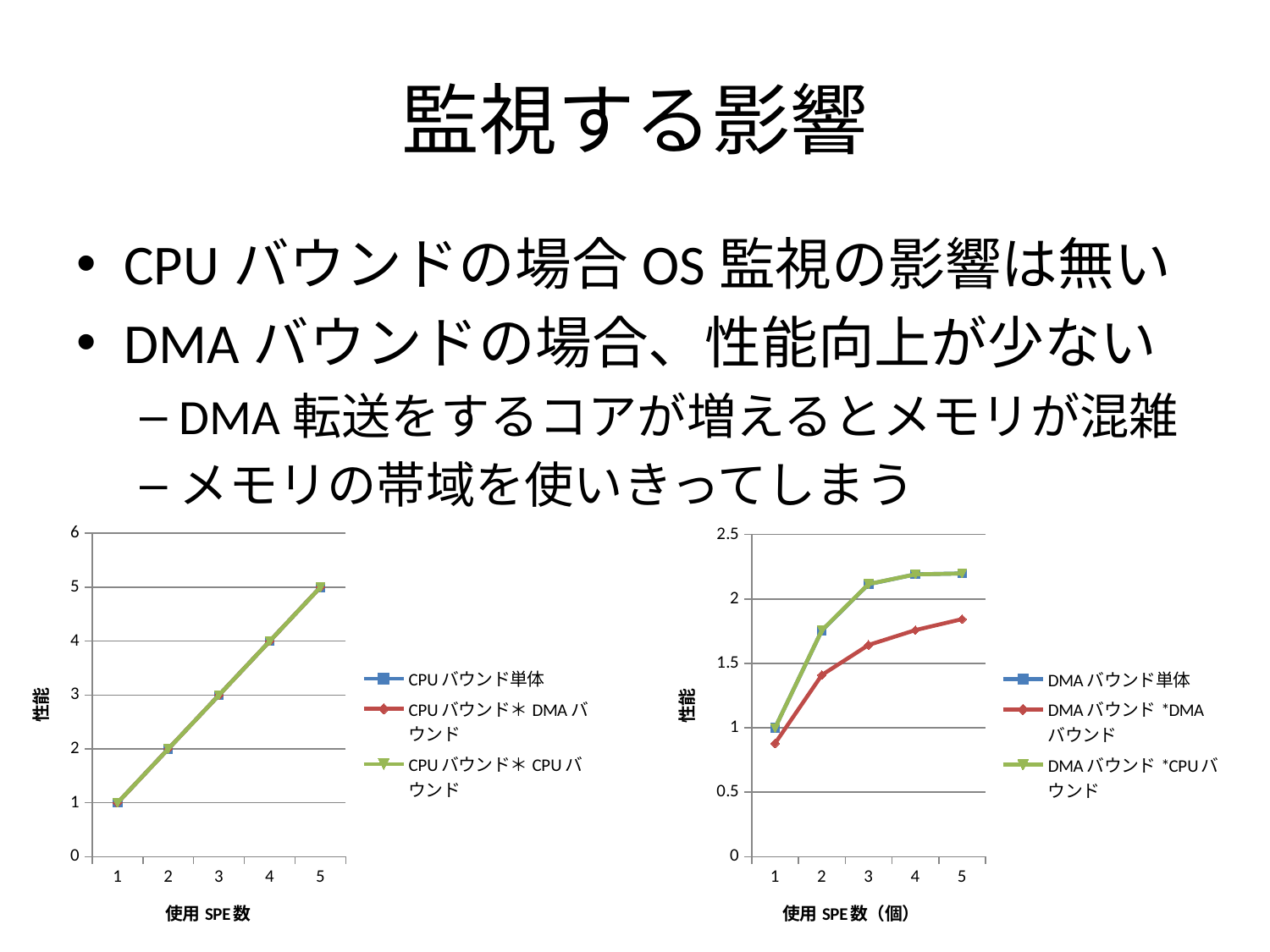
In the left chart, what is the performance value for CPU バウンド＊CPU バウンド at 3 SPEs? 3 How many series does the legend of the right chart list? 3 In the right chart, is the value for DMA バウンド *DMA バウンド at 5 SPEs greater or less than 2? less What kind of chart is the left chart (CPU bound)? line chart What is the x-axis title of the right chart? 使用 SPE 数（個） In the left chart, what is the performance value for CPU バウンド単体 at 5 SPEs? 5 In the left chart, how many SPE counts are plotted along the x axis? 5 In the right chart, at 5 SPEs, which series has the larger value: DMA バウンド *CPU バウンド or DMA バウンド *DMA バウンド? DMA バウンド *CPU バウンド How many series does the legend of the left chart list? 3 In the left chart, do the performance values rise or fall as the number of SPEs increases? rise In the left chart, what is the difference between the value at 5 SPEs and the value at 1 SPE for CPU バウンド単体? 4 What kind of chart is the right chart (DMA bound)? line chart